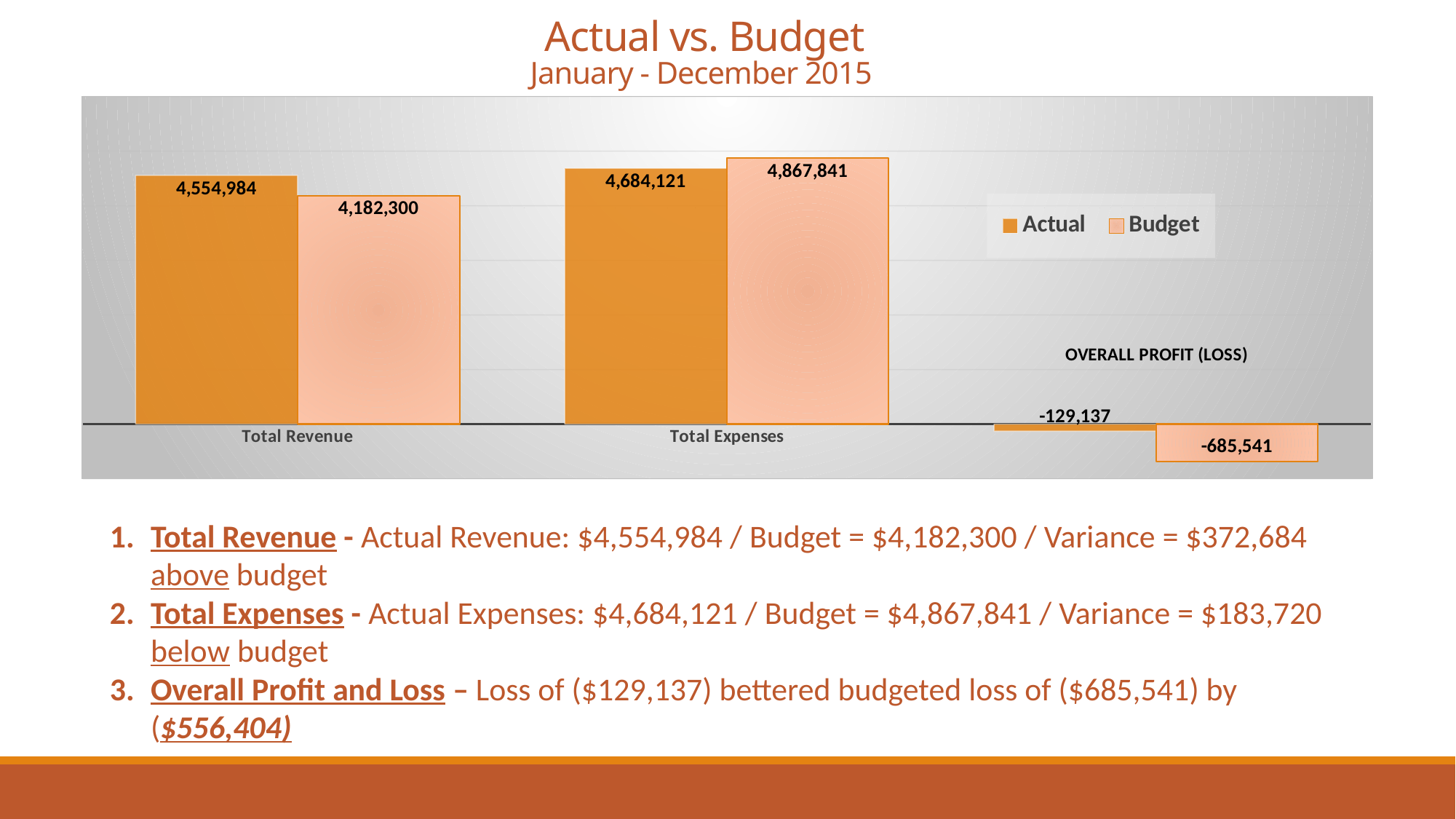
What is the Actual value for Total Revenue? 4,554,984 Which is larger for Total Expenses, the Actual value or the Budget value? Budget What is the Budget value for Total Expenses? 4,867,841 What is the Budget value for Total Revenue? 4,182,300 What is the Actual value for Overall Profit (Loss)? -129,137 Which category has the lowest Actual value? Overall Profit (Loss) What kind of chart is shown on the slide? Bar chart What is the difference between the Actual and Budget values for Total Revenue? 372,684 How many series does the legend list? 2 What is the Actual value for Total Expenses? 4,684,121 Which category has the highest Budget value? Total Expenses What is the Budget value for Overall Profit (Loss)? -685,541